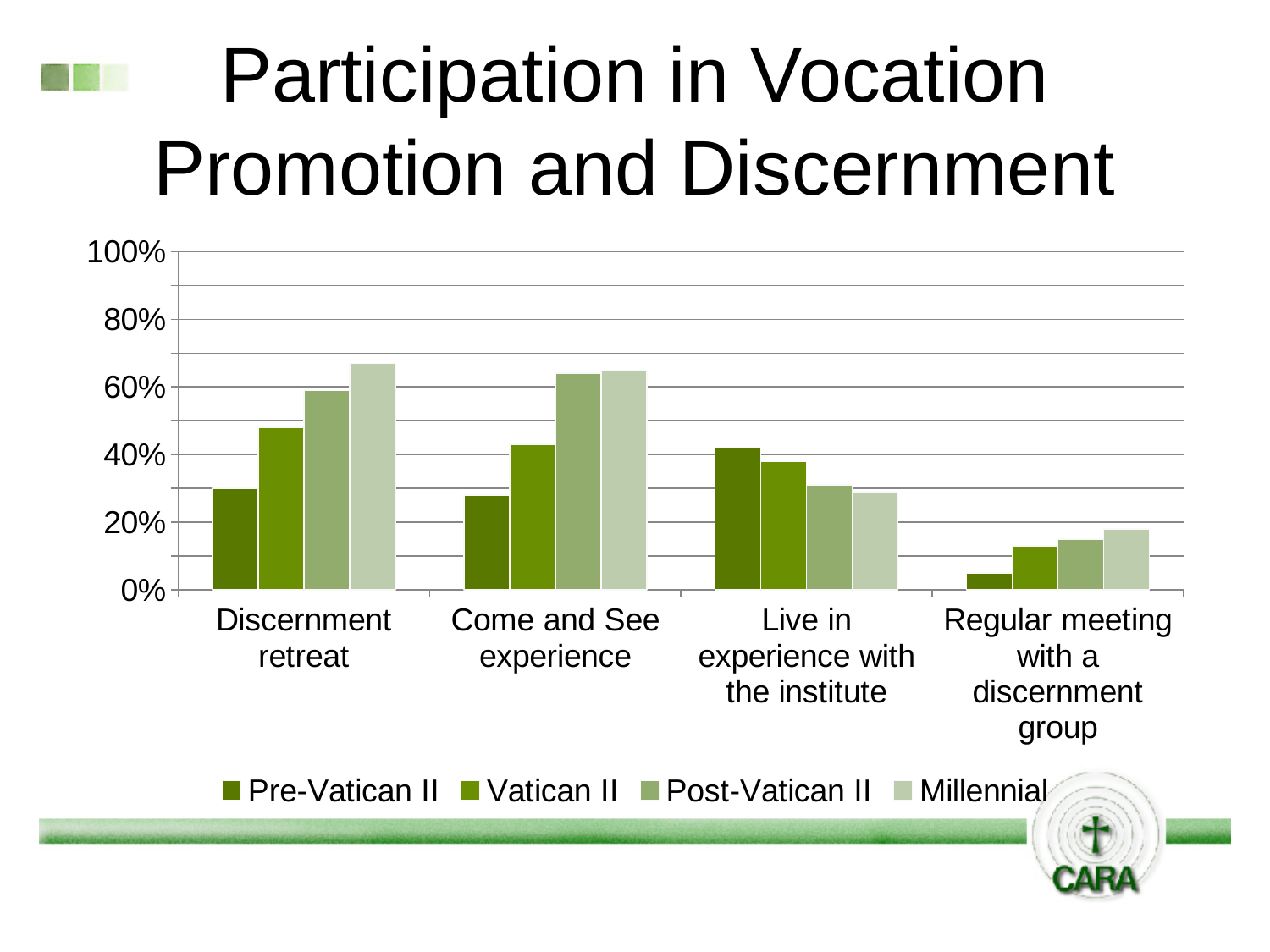
For Live in experience with the institute, which series has the highest value? Pre-Vatican II Is the Millennial value for Come and See experience greater or less than 60%? greater For Live in experience with the institute, do the values rise or fall going from Pre-Vatican II to Millennial? fall Is the Pre-Vatican II value for Discernment retreat greater or less than 40%? less For Regular meeting with a discernment group, which series has the lowest value? Pre-Vatican II How many categories are shown along the x axis? 4 What kind of chart is shown on the slide? bar chart For Discernment retreat, which series has the highest value? Millennial Is the Pre-Vatican II value for Regular meeting with a discernment group greater or less than 20%? less For Discernment retreat, which is larger: the Vatican II value or the Pre-Vatican II value? Vatican II How many series does the legend list? 4